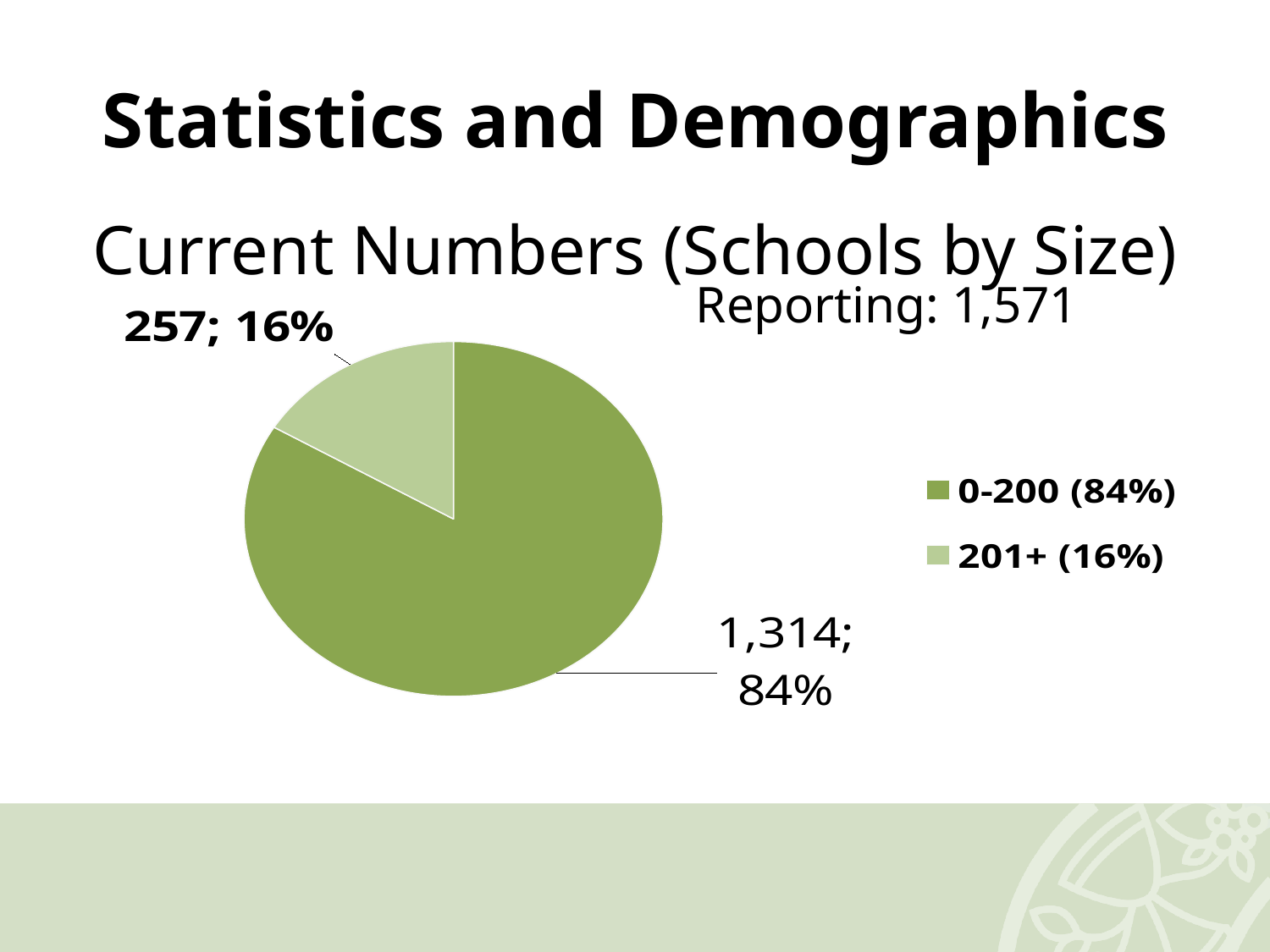
Which category has the largest slice of the pie? 0-200 How many schools are in the 201+ size category? 257 How many entries does the legend list? 2 What share of the pie does the 0-200 category represent? 84% How many schools are in the 0-200 size category? 1,314 What is the difference between the number of schools in the 0-200 category and the 201+ category? 1,057 Which category has more schools, 0-200 or 201+? 0-200 What is the total number of schools reporting shown on the slide? 1,571 What share of the pie does the 201+ category represent? 16% Which category has the smallest slice of the pie? 201+ How many slices does the pie chart have? 2 What kind of chart is shown on the slide? pie chart